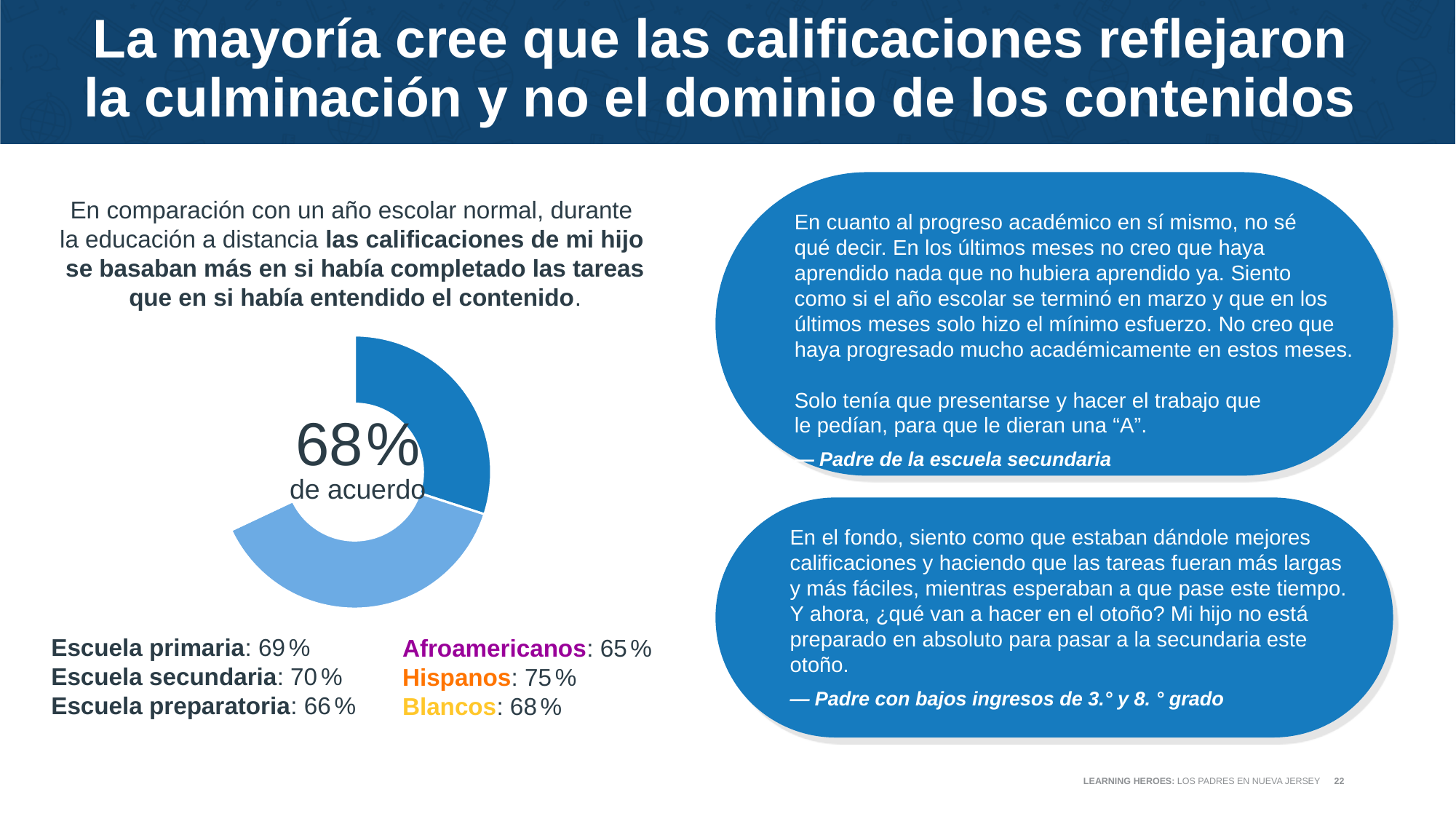
Which segment of the donut chart is larger, the dark blue one or the light blue one? The light blue one According to the breakdown below the donut chart, what percentage of Escuela primaria parents agree? 69% What percentage is shown in the centre of the donut chart? 68% How many segments does the donut chart have? 2 What share of the donut does the 'de acuerdo' segment represent? 68% What kind of chart is shown on the left of the slide? Donut (pie) chart In the breakdown below the donut chart, which group has the highest percentage in agreement? Hispanos According to the breakdown below the donut chart, what percentage of Hispanos agree? 75% In the breakdown below the donut chart, which group has the lowest percentage in agreement? Afroamericanos In the breakdown below the donut chart, what is the difference between Escuela secundaria (70%) and Escuela preparatoria (66%)? 4 percentage points What label appears under the 68% in the centre of the donut chart? de acuerdo